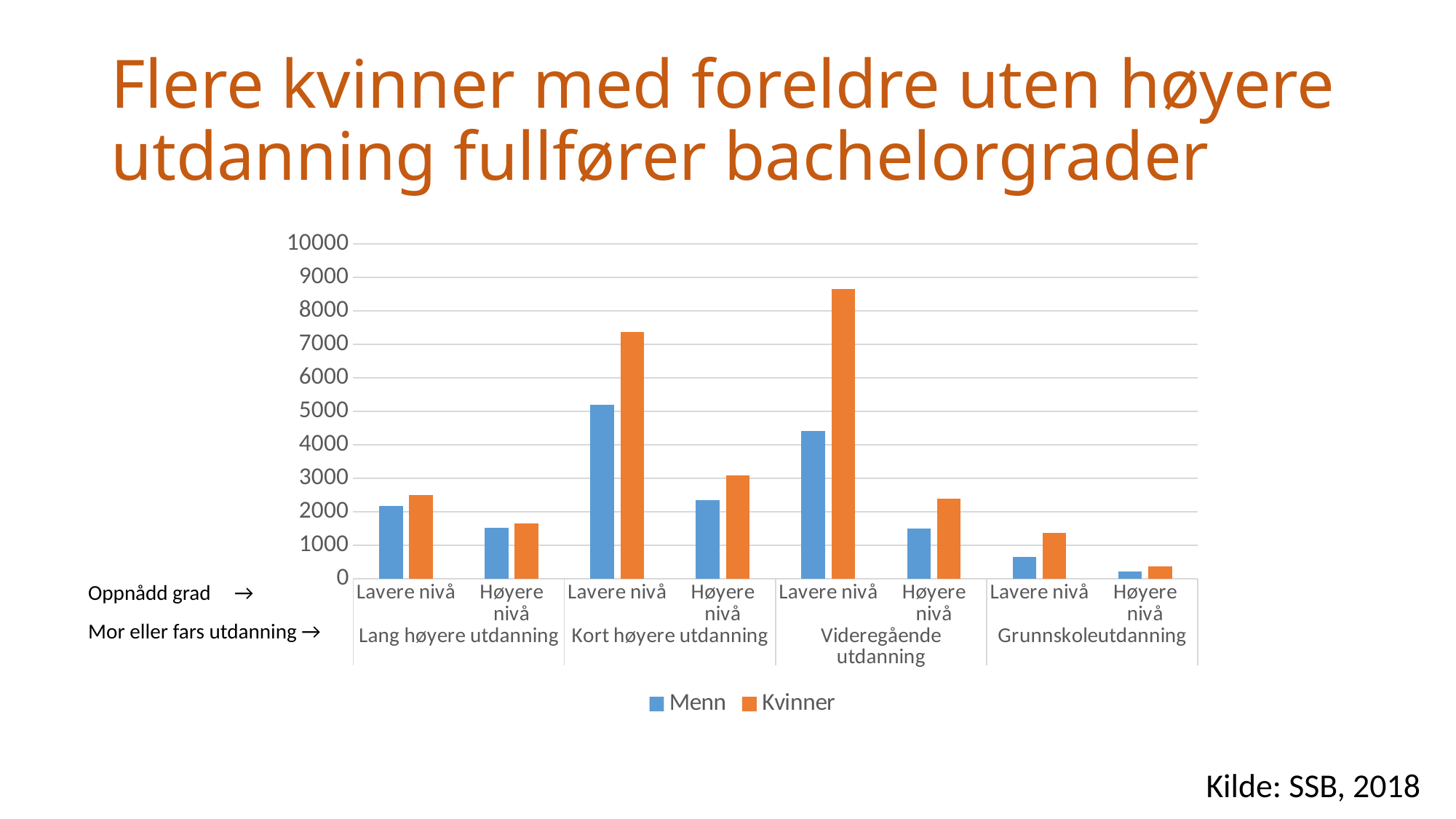
Is the value for Menn at Lavere nivå under Kort høyere utdanning greater or less than 5000? greater Which is larger: Menn at Lavere nivå under Kort høyere utdanning, or Menn at Lavere nivå under Videregående utdanning? Menn at Lavere nivå under Kort høyere utdanning Is the value for Kvinner at Lavere nivå under Kort høyere utdanning greater or less than 7000? greater Is the value for Kvinner at Lavere nivå under Videregående utdanning greater or less than 8000? greater Which bar is the highest in the chart? Kvinner, Lavere nivå, Videregående utdanning Under Videregående utdanning at Lavere nivå, which is larger, Menn or Kvinner? Kvinner What are the two series named in the legend? Menn and Kvinner How many parent-education groups (Mor eller fars utdanning) are shown along the x axis? 4 What kind of chart is shown on the slide? bar chart How many series does the legend list? 2 Which bar is the lowest in the chart? Menn, Høyere nivå, Grunnskoleutdanning